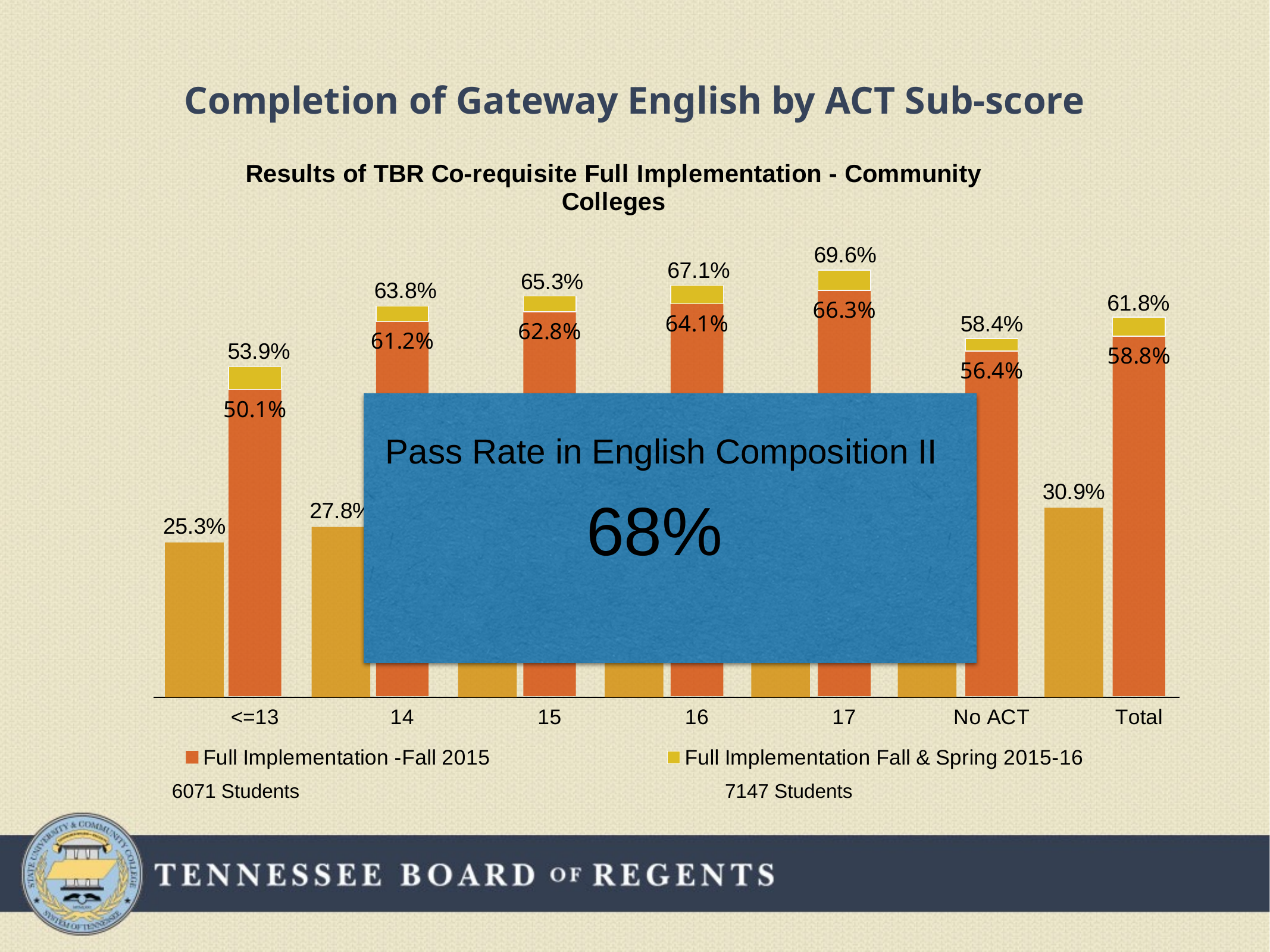
Which ACT sub-score category has the highest Full Implementation Fall & Spring 2015-16 value? 17 Which is larger for ACT sub-score 14: the Full Implementation -Fall 2015 value or the Full Implementation Fall & Spring 2015-16 value? Full Implementation Fall & Spring 2015-16 What is the title of the chart? Results of TBR Co-requisite Full Implementation - Community Colleges How many categories are shown on the x axis of the chart? 7 What is the Full Implementation -Fall 2015 value for ACT sub-score 17? 66.3% What is the difference between the Full Implementation Fall & Spring 2015-16 value and the Full Implementation -Fall 2015 value for ACT sub-score 16? 3.0% Which category has the lowest Full Implementation -Fall 2015 value? <=13 What is the Full Implementation Fall & Spring 2015-16 value for the Total category? 61.8% How many series does the chart legend list? 2 What kind of chart is shown on the slide? Bar chart Do the Full Implementation -Fall 2015 values rise or fall from ACT sub-score <=13 to 17? Rise What is the Full Implementation -Fall 2015 value for the No ACT category? 56.4%